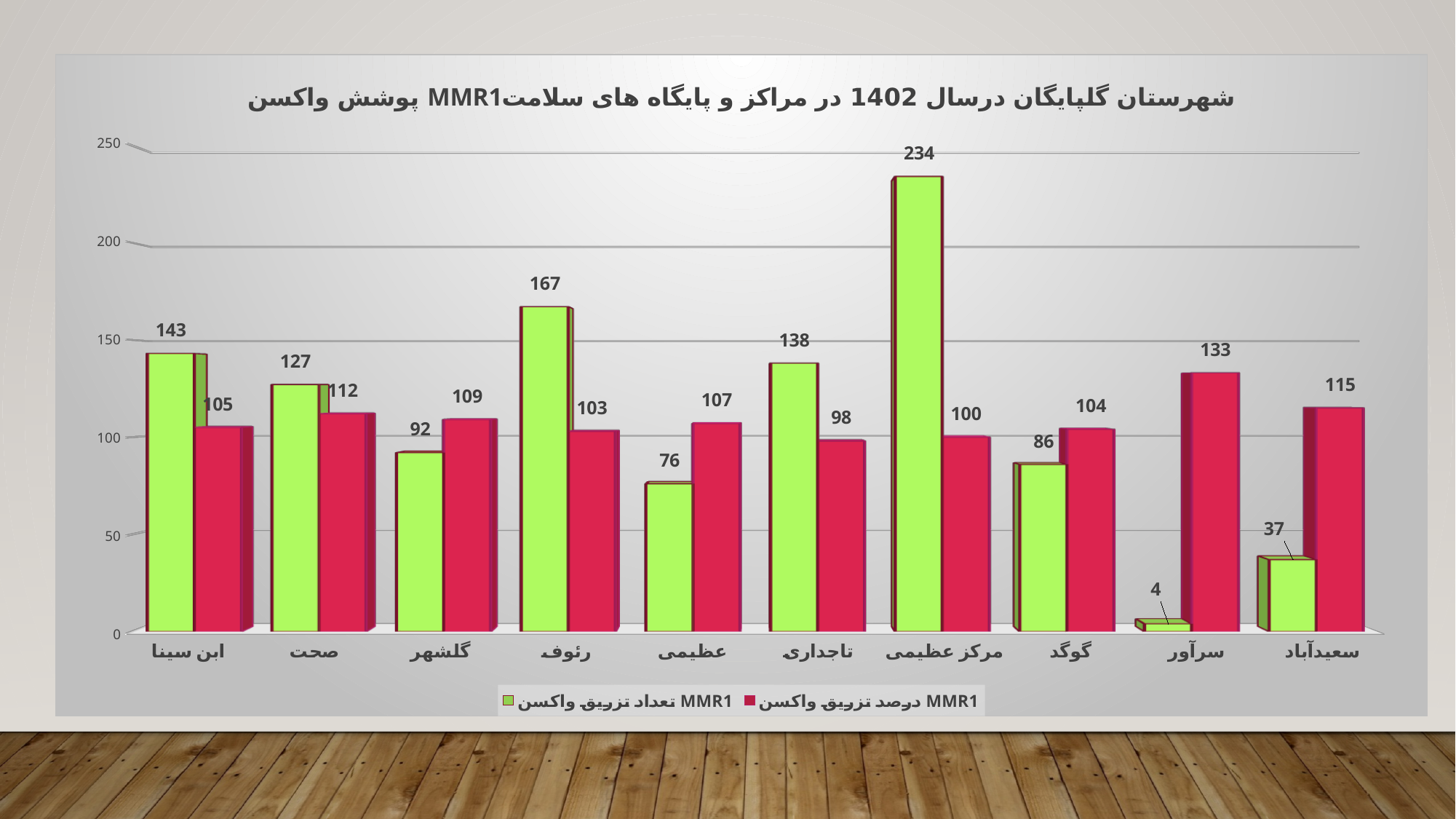
Which category has the lowest value in the red series (درصد تزریق واکسن MMR1)? تاجداری What is the value of the green series (تعداد تزریق واکسن MMR1) for مرکز عظیمی? 234 What is the difference between the red series values for سرآور and تاجداری? 35 What is the difference between the green series values for مرکز عظیمی and رئوف? 67 Which category has the lowest value in the green series (تعداد تزریق واکسن MMR1)? سرآور How many categories are shown on the x axis? 10 What is the value of the green series (تعداد تزریق واکسن MMR1) for رئوف? 167 Which category has the highest value in the green series (تعداد تزریق واکسن MMR1)? مرکز عظیمی How many series does the legend list? 2 What kind of chart is shown on the slide? bar chart Which is larger for سعیدآباد: the green series value or the red series value? the red series value (115) What is the value of the red series (درصد تزریق واکسن MMR1) for سرآور? 133